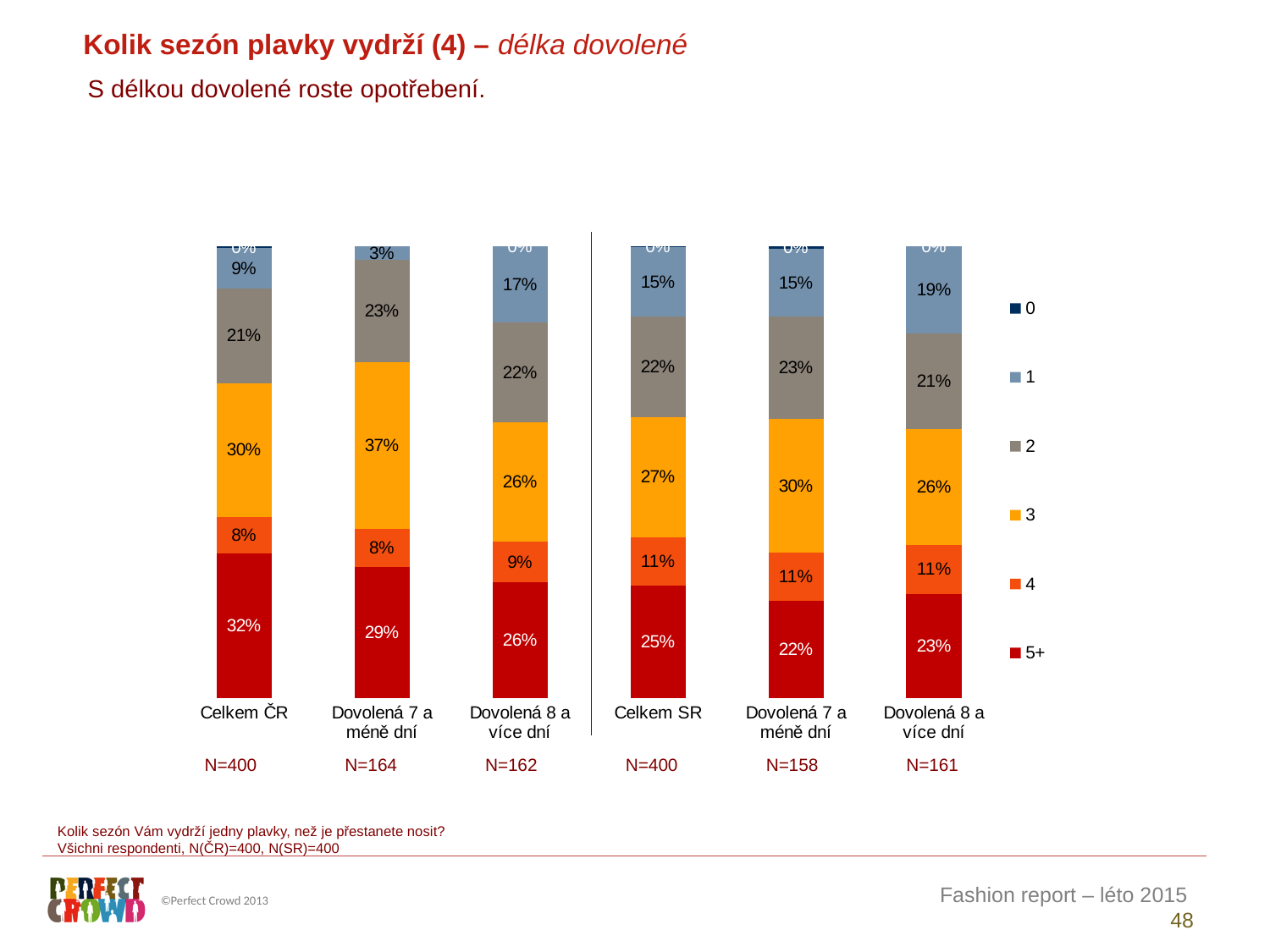
How many bars (categories) are plotted in the chart? 6 What is the value of the "5+" segment for Celkem ČR? 32% What is the difference between the "5+" values for Celkem ČR and Celkem SR? 7 percentage points What is the value of the "3" segment for the Czech "Dovolená 7 a méně dní" bar (second bar from the left)? 37% Which bar has the lowest "1" value? Dovolená 7 a méně dní (ČR) How many series does the legend list? 6 What kind of chart is shown on the slide? stacked bar chart Which is larger: the "3" value for Celkem ČR or the "3" value for Celkem SR? Celkem ČR Which bar has the highest "5+" value? Celkem ČR What is the sample size (N) shown under the Celkem SR bar? N=400 What is the value of the "1" segment for Celkem SR? 15% What is the value of the "2" segment for the Slovak "Dovolená 8 a více dní" bar (rightmost bar)? 21%